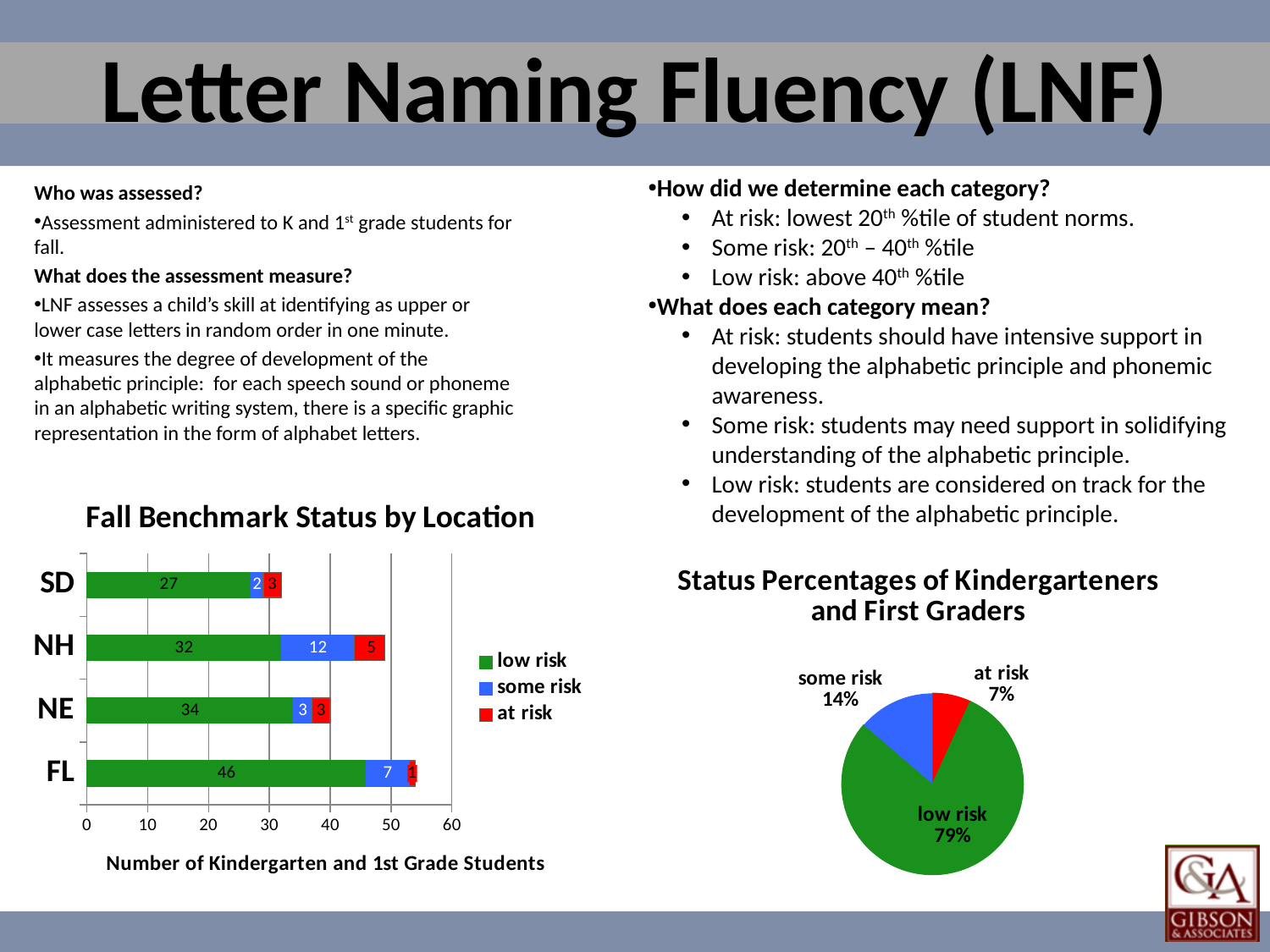
In the 'Status Percentages of Kindergarteners and First Graders' pie chart, which category has the largest share? low risk In the 'Fall Benchmark Status by Location' chart, what is the difference between the low risk values for NE and SD? 7 In the 'Fall Benchmark Status by Location' chart, what is the low risk value for FL? 46 What kind of chart is 'Fall Benchmark Status by Location'? bar chart In the 'Fall Benchmark Status by Location' chart, how many locations are shown? 4 In the 'Fall Benchmark Status by Location' chart, which location has the highest low risk value? FL In the 'Fall Benchmark Status by Location' chart, what is the total number of students for NH across all three categories? 49 In the 'Fall Benchmark Status by Location' chart, which location has the lowest at risk value? FL In the 'Status Percentages of Kindergarteners and First Graders' pie chart, what share is some risk? 14% In the 'Fall Benchmark Status by Location' chart, how many series does the legend list? 3 In the 'Fall Benchmark Status by Location' chart, what is the some risk value for NH? 12 In the 'Fall Benchmark Status by Location' chart, what is the at risk value for SD? 3